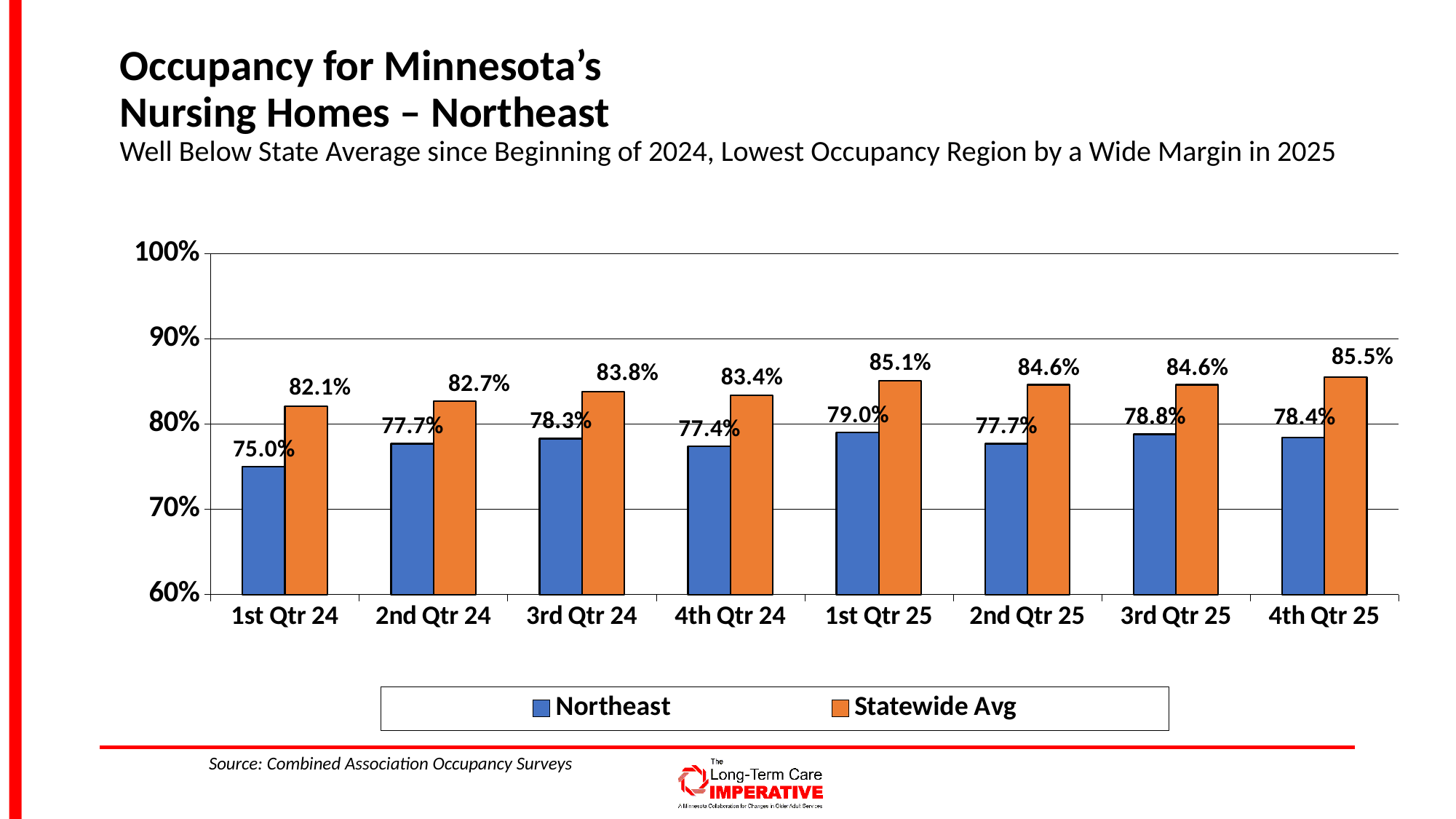
How many series does the legend list? 2 Is the Northeast value for 2nd Qtr 25 greater or less than 80%? less What is the Statewide Avg occupancy value for 4th Qtr 25? 85.5% How many quarters are shown on the x axis? 8 In which quarter is the Statewide Avg occupancy highest? 4th Qtr 25 What kind of chart is shown on the slide? bar chart What is the Northeast occupancy value for 1st Qtr 24? 75.0% Which is larger in 3rd Qtr 24, the Northeast value or the Statewide Avg value? Statewide Avg In which quarter is the Northeast occupancy lowest? 1st Qtr 24 What is the difference between the Statewide Avg and Northeast values in 1st Qtr 24? 7.1% What is the Northeast occupancy value for 1st Qtr 25? 79.0% What is the difference between the Statewide Avg and Northeast values in 4th Qtr 25? 7.1%